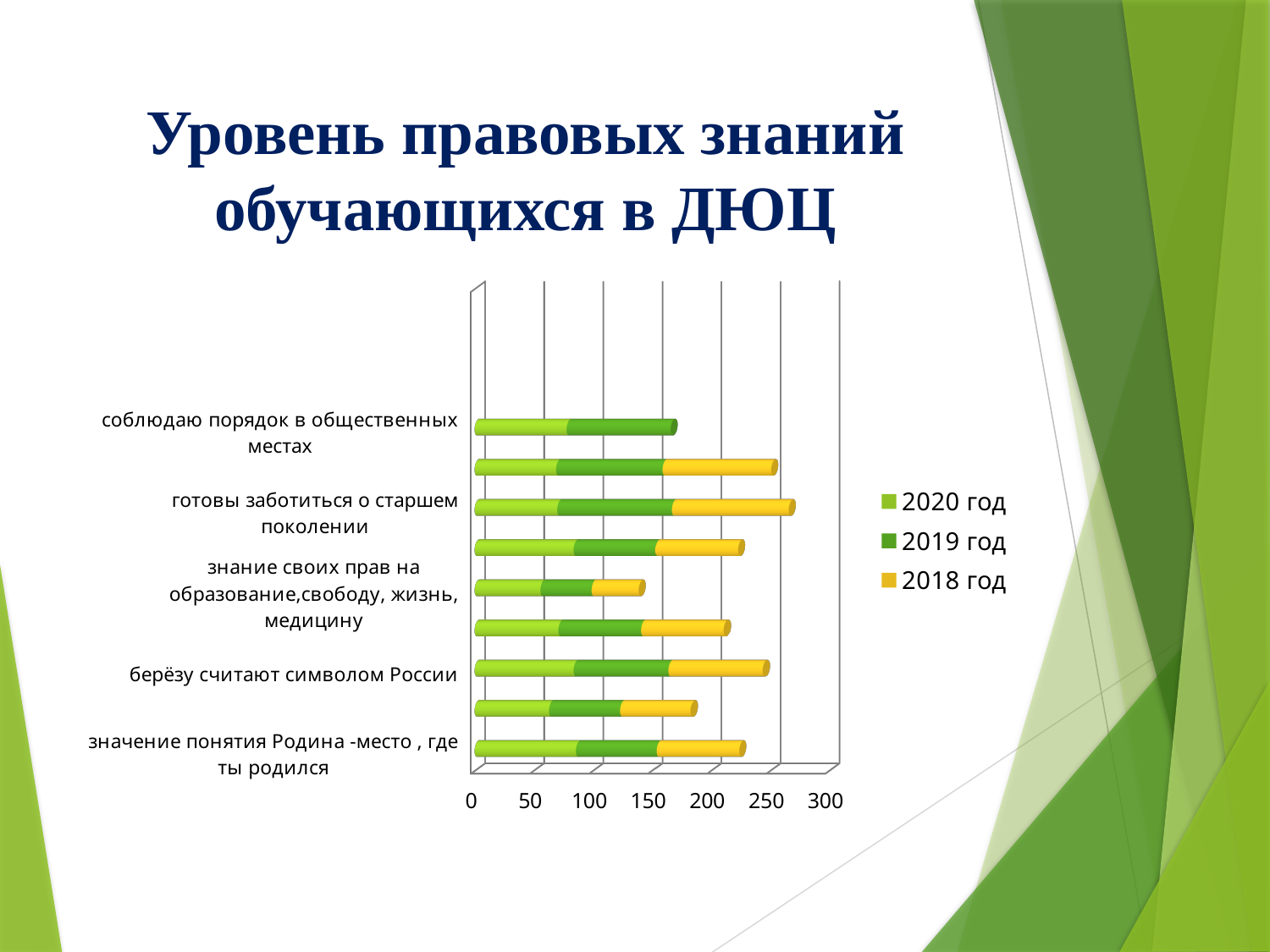
Is the total value for 'знание своих прав на образование, свободу, жизнь, медицину' greater or less than 200? less Is the total value for 'берёзу считают символом России' greater or less than 200? greater Is the total value for 'готовы заботиться о старшем поколении' greater or less than 200? greater How many series does the legend list? 3 Which labelled category has no 2018 год segment in its bar? соблюдаю порядок в общественных местах Which has the larger total bar: 'готовы заботиться о старшем поколении' or 'знание своих прав на образование, свободу, жизнь, медицину'? готовы заботиться о старшем поколении What kind of chart is shown on the slide? bar chart Which years are listed in the legend? 2020 год, 2019 год, 2018 год Which labelled category has the shortest total bar? знание своих прав на образование, свободу, жизнь, медицину Which colour represents 2018 год in the chart? yellow How many bars are plotted in the chart? 9